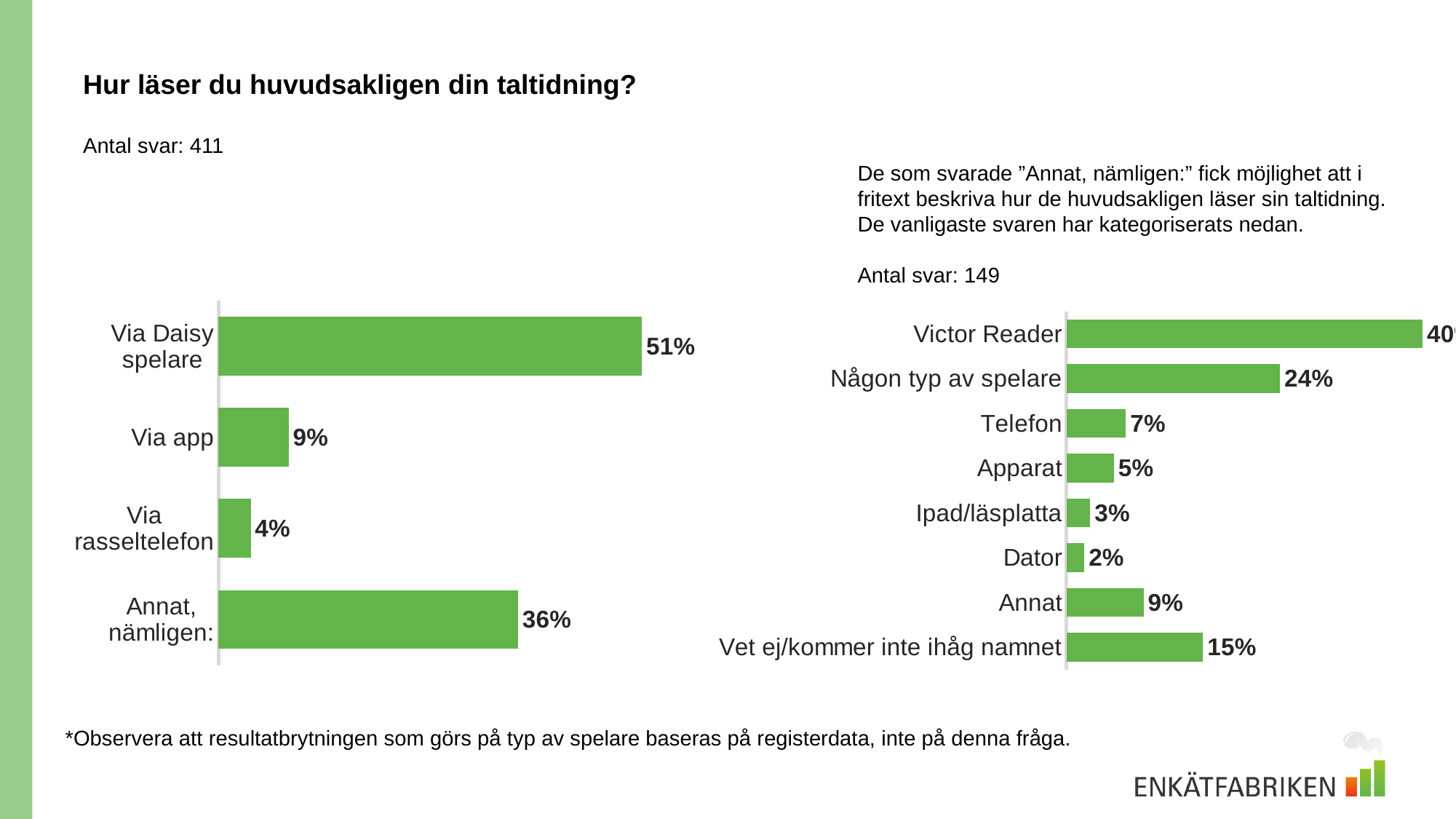
In the left chart, what percentage of respondents read their talking newspaper via Daisy spelare? 51% In the left chart, what is the difference between Via Daisy spelare and Annat, nämligen:? 15 percentage points What type of chart is the left chart? Bar chart In the right chart, what is the value for Vet ej/kommer inte ihåg namnet? 15% In the left chart, what is the value for Via app? 9% In the right chart, which category has the highest value? Victor Reader How many categories does the left chart show? 4 In the right chart, which category has the lowest value? Dator In the right chart, which is larger: Telefon or Apparat? Telefon How many categories does the right chart show? 8 In the left chart, which category has the lowest value? Via rasseltelefon In the right chart, what is the value for Någon typ av spelare? 24%